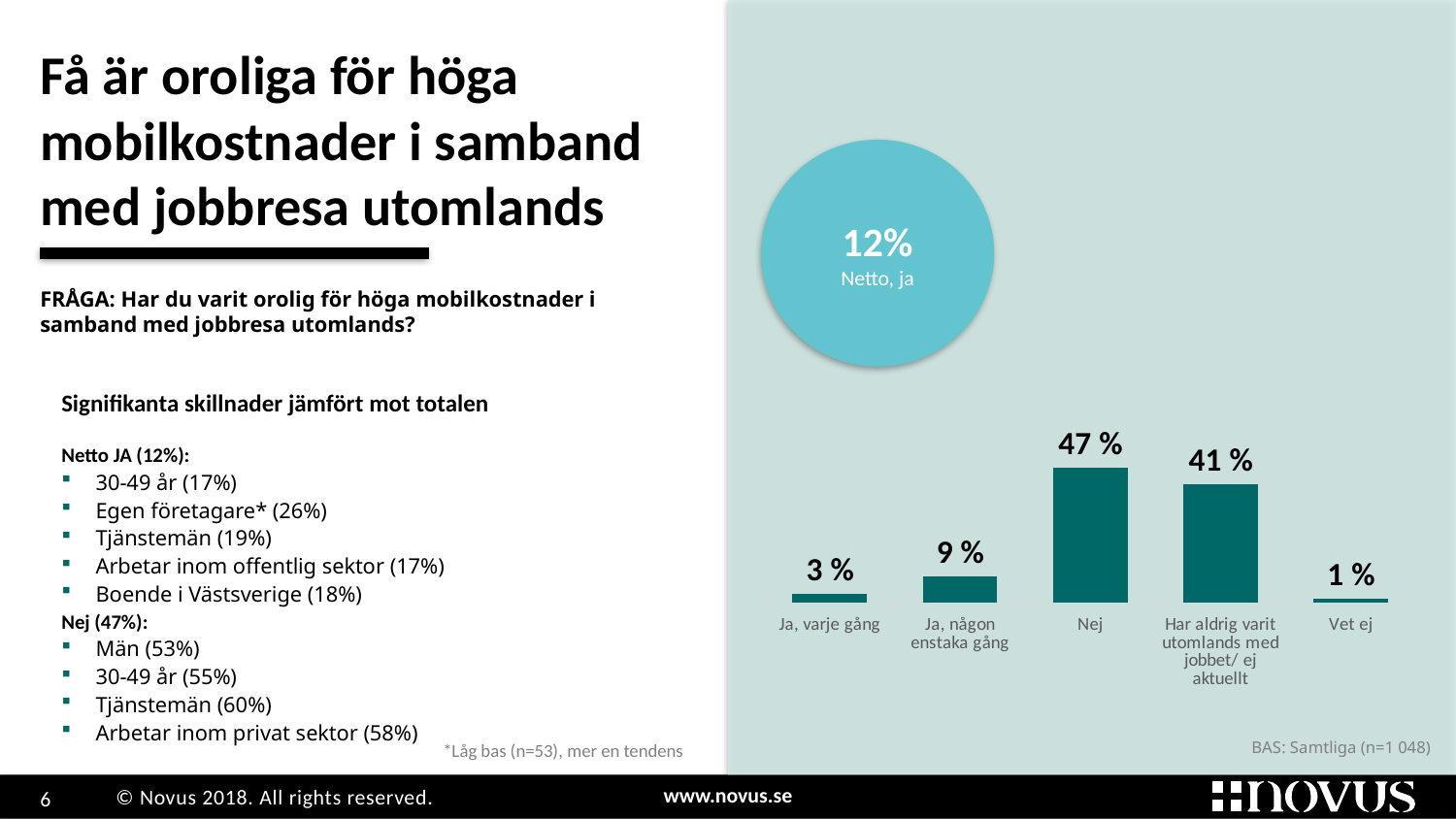
Which category has the lowest value in the bar chart? Vet ej What is the value for "Nej" in the bar chart? 47 % What is the value for "Ja, varje gång" in the bar chart? 3 % What is the value for "Vet ej" in the bar chart? 1 % Which category has the highest value in the bar chart? Nej What is the difference between the values for "Nej" and "Har aldrig varit utomlands med jobbet/ ej aktuellt"? 6 % How many categories are shown in the bar chart? 5 What percentage is shown in the circle labelled "Netto, ja"? 12% What is the value for "Ja, någon enstaka gång" in the bar chart? 9 % What is the value for "Har aldrig varit utomlands med jobbet/ ej aktuellt" in the bar chart? 41 % Which is larger in the bar chart: "Ja, någon enstaka gång" or "Ja, varje gång"? Ja, någon enstaka gång What kind of chart is shown on the right side of the slide? Bar chart